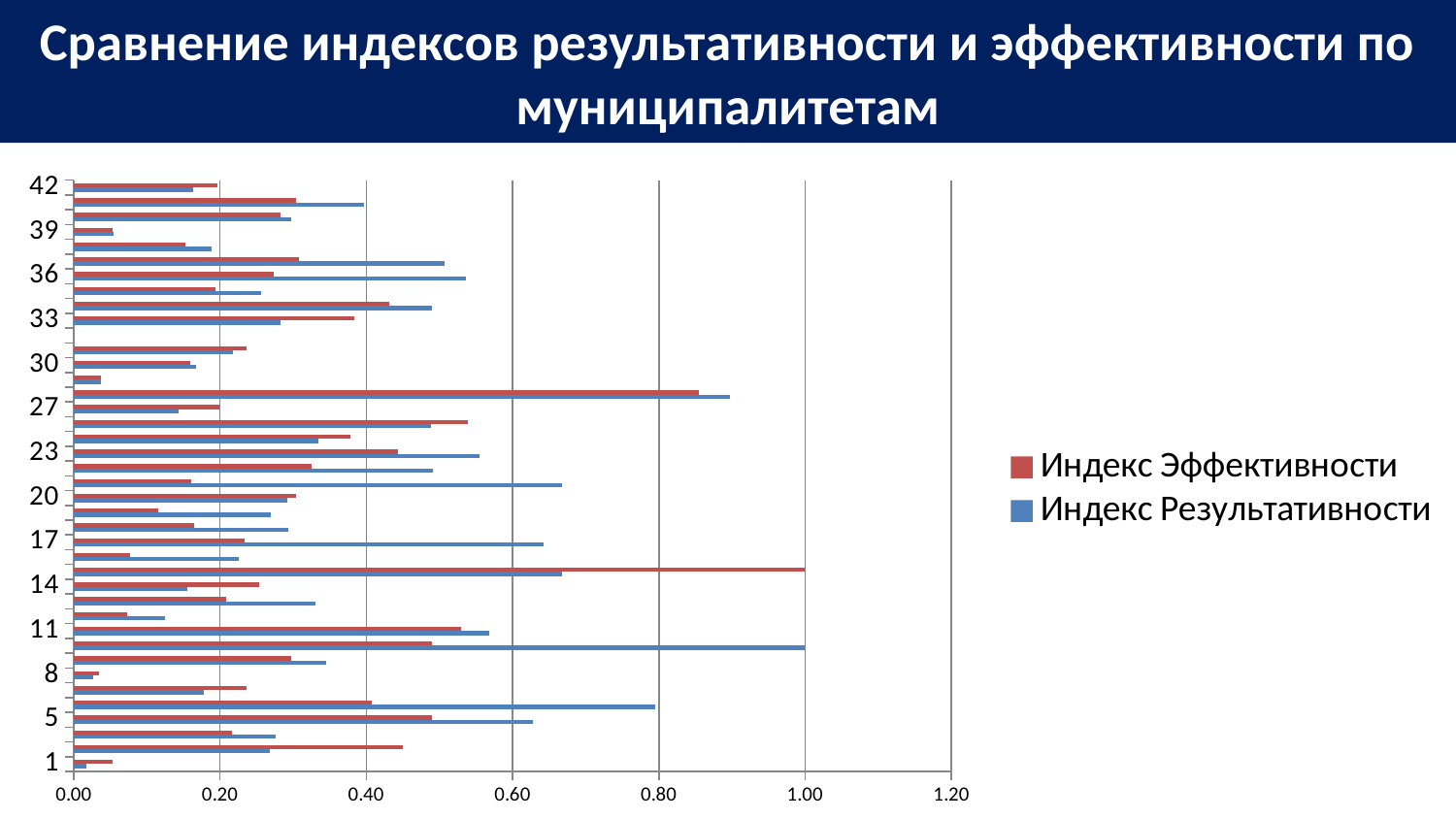
How many series does the legend list? 2 Is the Индекс Эффективности value for municipality 8 greater or less than 0.20? less For municipality 36, which is larger: Индекс Эффективности or Индекс Результативности? Индекс Результативности What kind of chart is shown on the slide? bar chart What are the two series named in the legend? Индекс Эффективности and Индекс Результативности Is the Индекс Результативности value for municipality 36 greater or less than 0.40? greater Is the Индекс Эффективности value for municipality 11 greater or less than 0.40? greater For municipality 5, which is larger: Индекс Эффективности or Индекс Результативности? Индекс Результативности Which colour represents Индекс Результативности in the chart? blue For municipality 17, which is larger: Индекс Эффективности or Индекс Результативности? Индекс Результативности